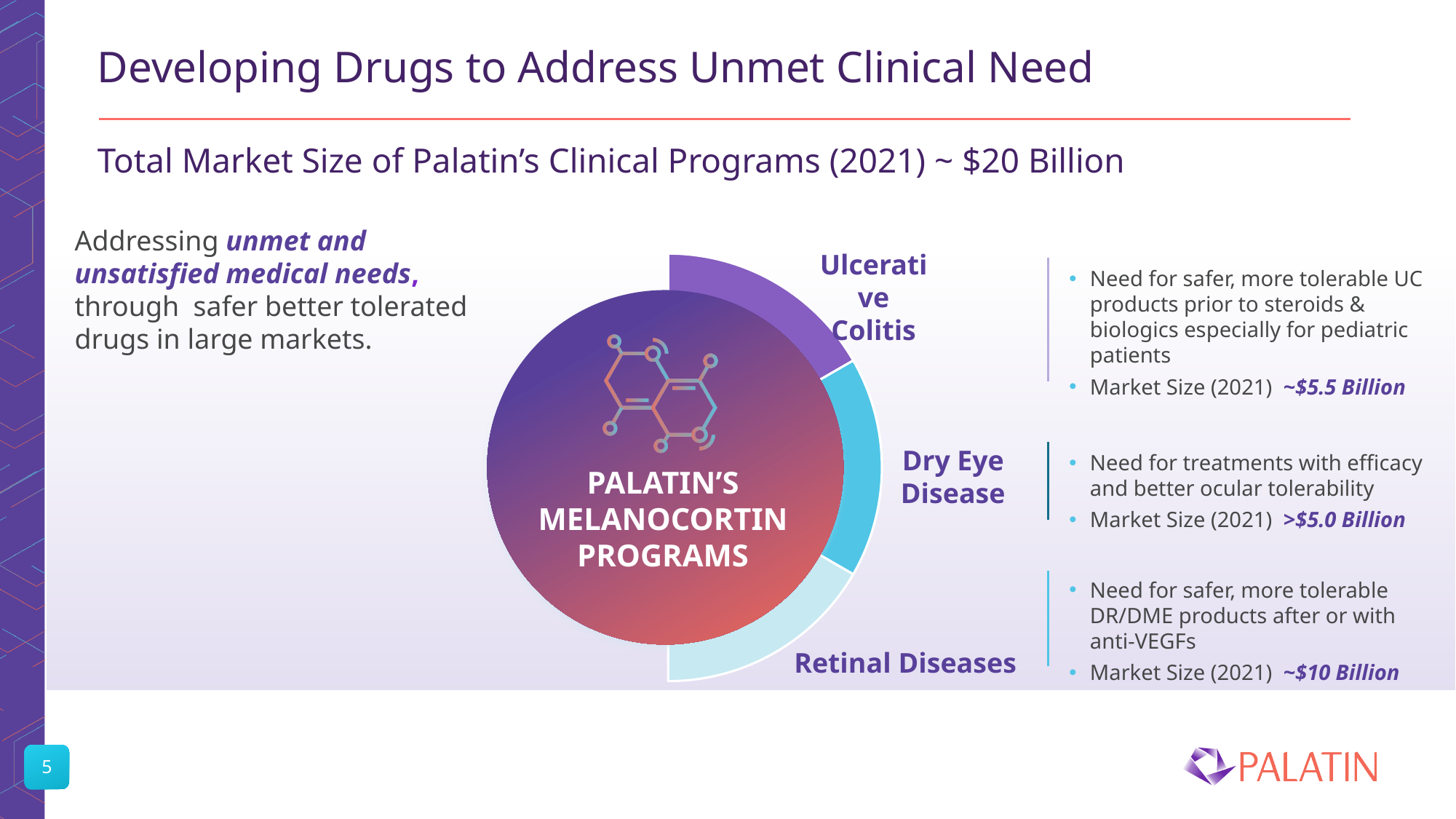
What total market size of Palatin's clinical programs (2021) is stated on the slide? ~$20 Billion What is the stated 2021 market size for Dry Eye Disease? >$5.0 Billion How many disease segments are shown in the ring chart around "Palatin's Melanocortin Programs"? 3 What is the stated 2021 market size for Retinal Diseases? ~$10 Billion What text appears in the centre of the ring chart? PALATIN'S MELANOCORTIN PROGRAMS What kind of chart is used to show Palatin's clinical program areas? Donut (ring) chart Which has the larger stated 2021 market size, Retinal Diseases or Ulcerative Colitis? Retinal Diseases Which segment of the ring chart is coloured purple? Ulcerative Colitis What is the stated 2021 market size for Ulcerative Colitis? ~$5.5 Billion Which program area has the largest stated 2021 market size? Retinal Diseases Which has the larger stated 2021 market size, Retinal Diseases or Dry Eye Disease? Retinal Diseases